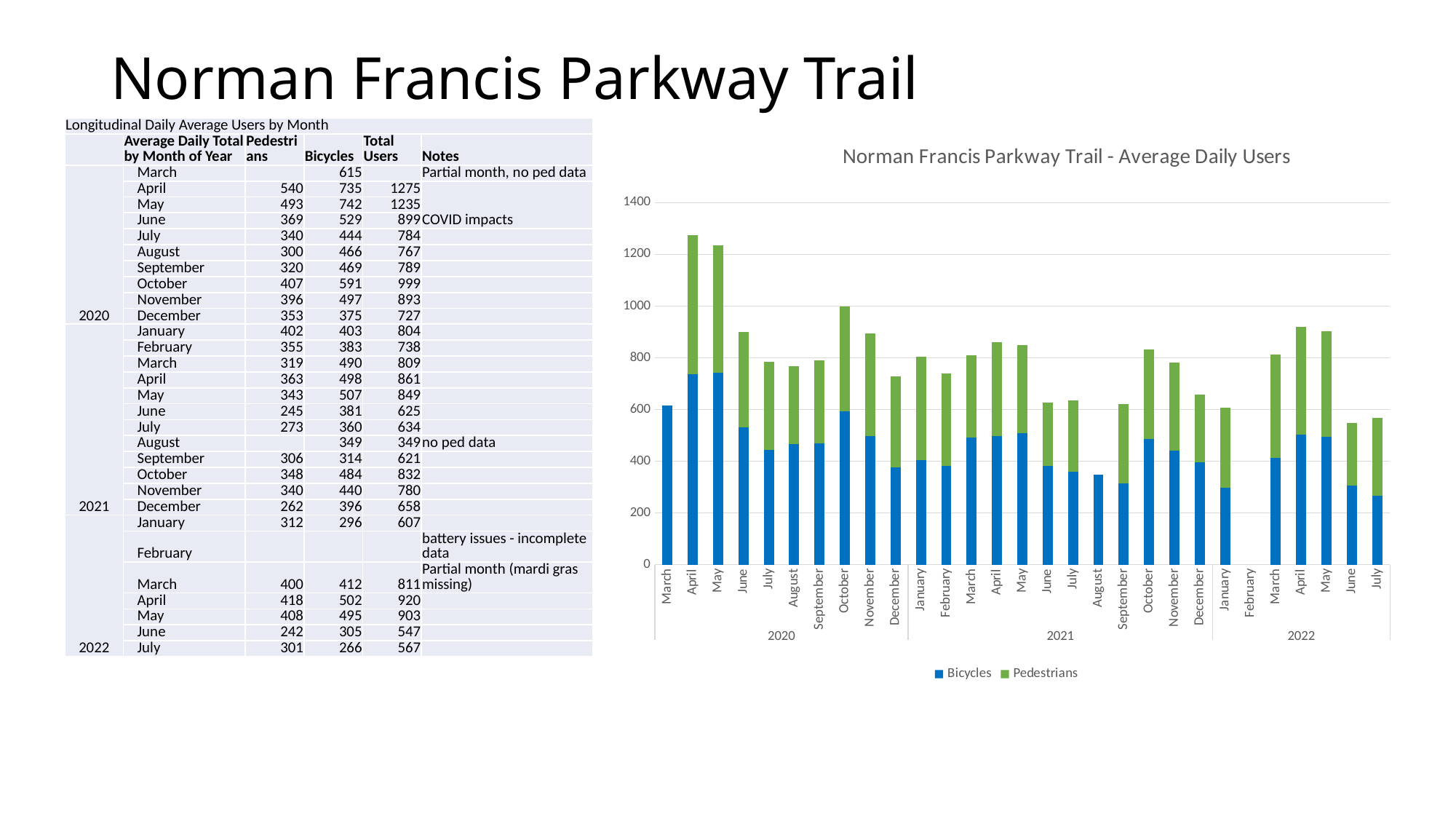
According to the table, what is the Bicycles value for April 2020? 735 Which month has the tallest stacked bar in the chart? April 2020 What kind of chart is shown on the right side of the slide? bar chart Is the bar for August 2021 greater or less than 400? less What are the two series named in the chart legend? Bicycles and Pedestrians How many series does the legend of the chart list? 2 Is the total stacked bar for April 2020 greater or less than 1200? greater What is the title of the chart? Norman Francis Parkway Trail - Average Daily Users How many years are labelled along the x axis of the chart? 3 Using the Total Users values in the table, what is the difference between April 2020 and May 2020? 40 Which stacked bar is taller, June 2021 or October 2021? October 2021 What is the total of the stacked bar for October 2020, as printed in the table? 999